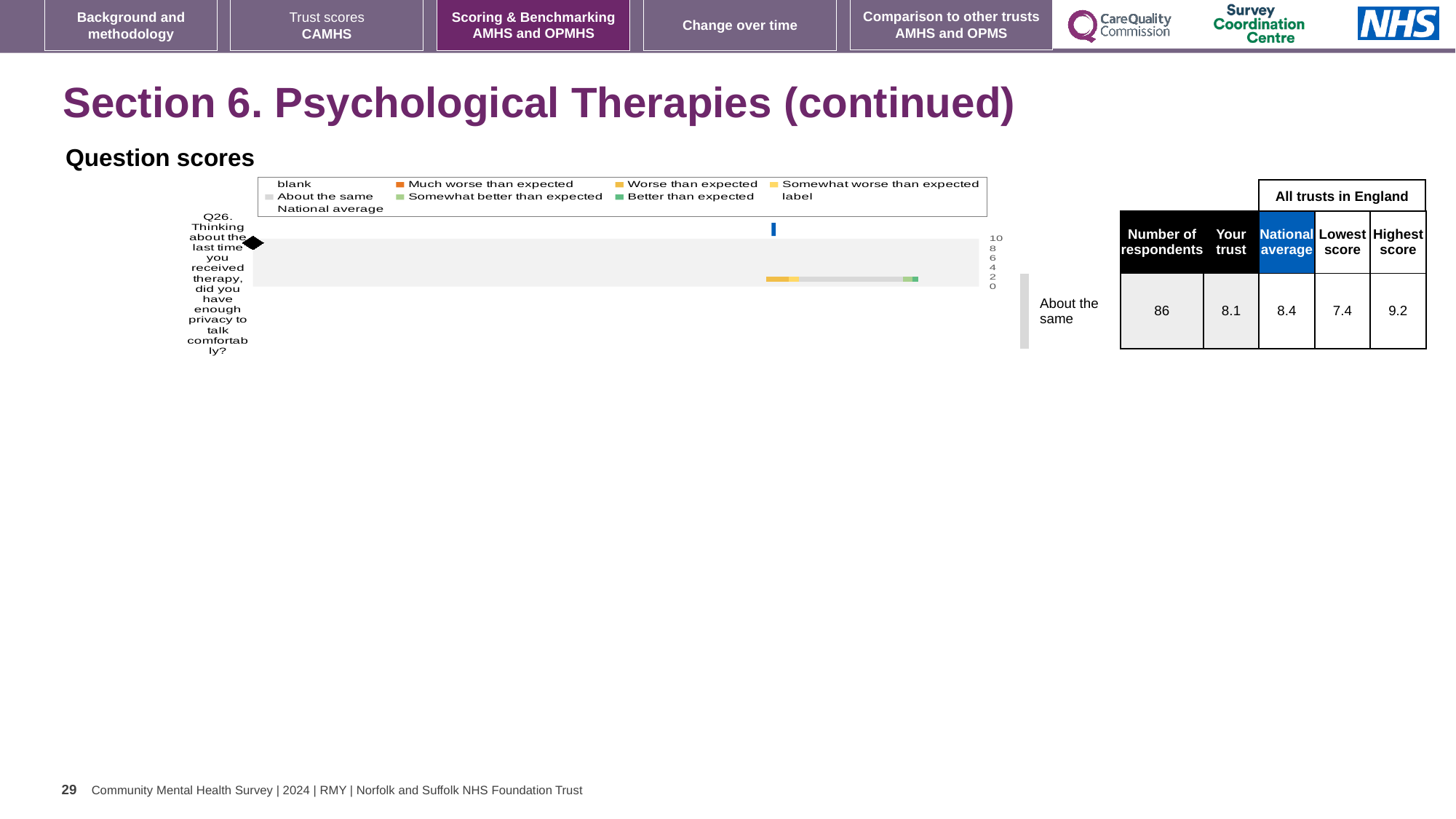
How is the trust's Q26 result categorised relative to expectations? About the same Which question is plotted on the chart? Q26. Thinking about the last time you received therapy, did you have enough privacy to talk comfortably? What is the 'Your trust' score for Q26? 8.1 What is the highest value shown on the chart's score axis? 10 Which is larger for Q26, the 'Your trust' score or the national average? National average What kind of chart is used to show the Q26 question score? bar chart How many survey questions are plotted on the chart? 1 What is the highest score among all trusts in England for Q26? 9.2 How many respondents answered Q26? 86 What is the difference between the highest score and the lowest score for Q26? 1.8 What is the lowest score among all trusts in England for Q26? 7.4 What is the national average score for Q26? 8.4